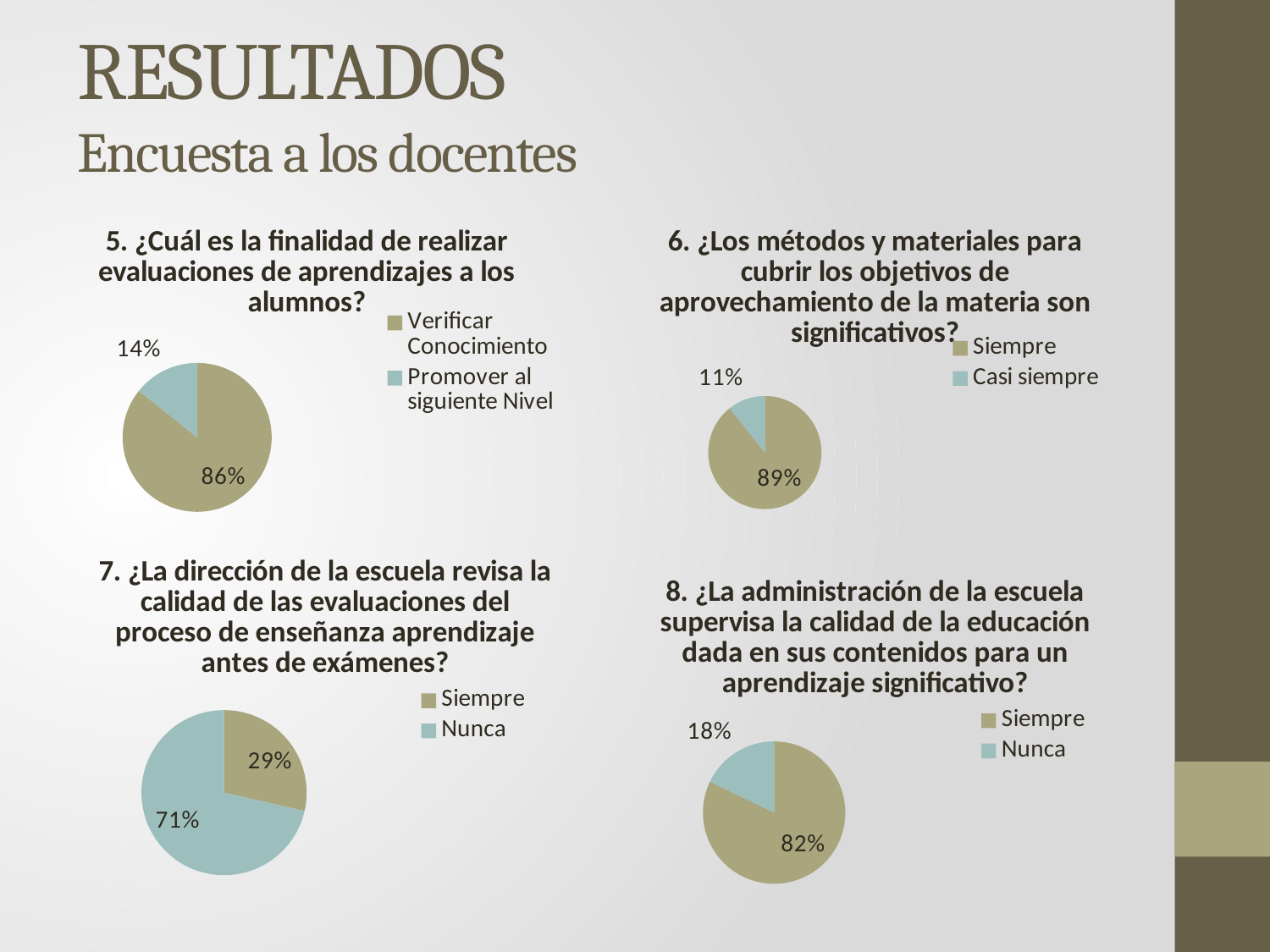
In the chart for question 7 (bottom left), which response has the largest share? Nunca In the chart for question 8 (bottom right), what percentage answered 'Siempre'? 82% How many categories does the legend of the chart for question 6 (top right) list? 2 Is the 'Siempre' share larger in the chart for question 6 (top right) or in the chart for question 8 (bottom right)? Question 6 What type of chart is used for question 7 (bottom left)? Pie chart In the chart for question 5 (top left), what share of respondents answered 'Promover al siguiente Nivel'? 14% In the chart for question 8 (bottom right), which response has the smallest share? Nunca In the chart for question 5 (top left), what share of respondents answered 'Verificar Conocimiento'? 86% In the chart for question 7 (bottom left), what is the difference in percentage points between 'Nunca' and 'Siempre'? 42 In the chart for question 6 (top right), what percentage answered 'Casi siempre'? 11% How many pie charts are shown on the slide? 4 In the chart for question 6 (top right), what percentage answered 'Siempre'? 89%